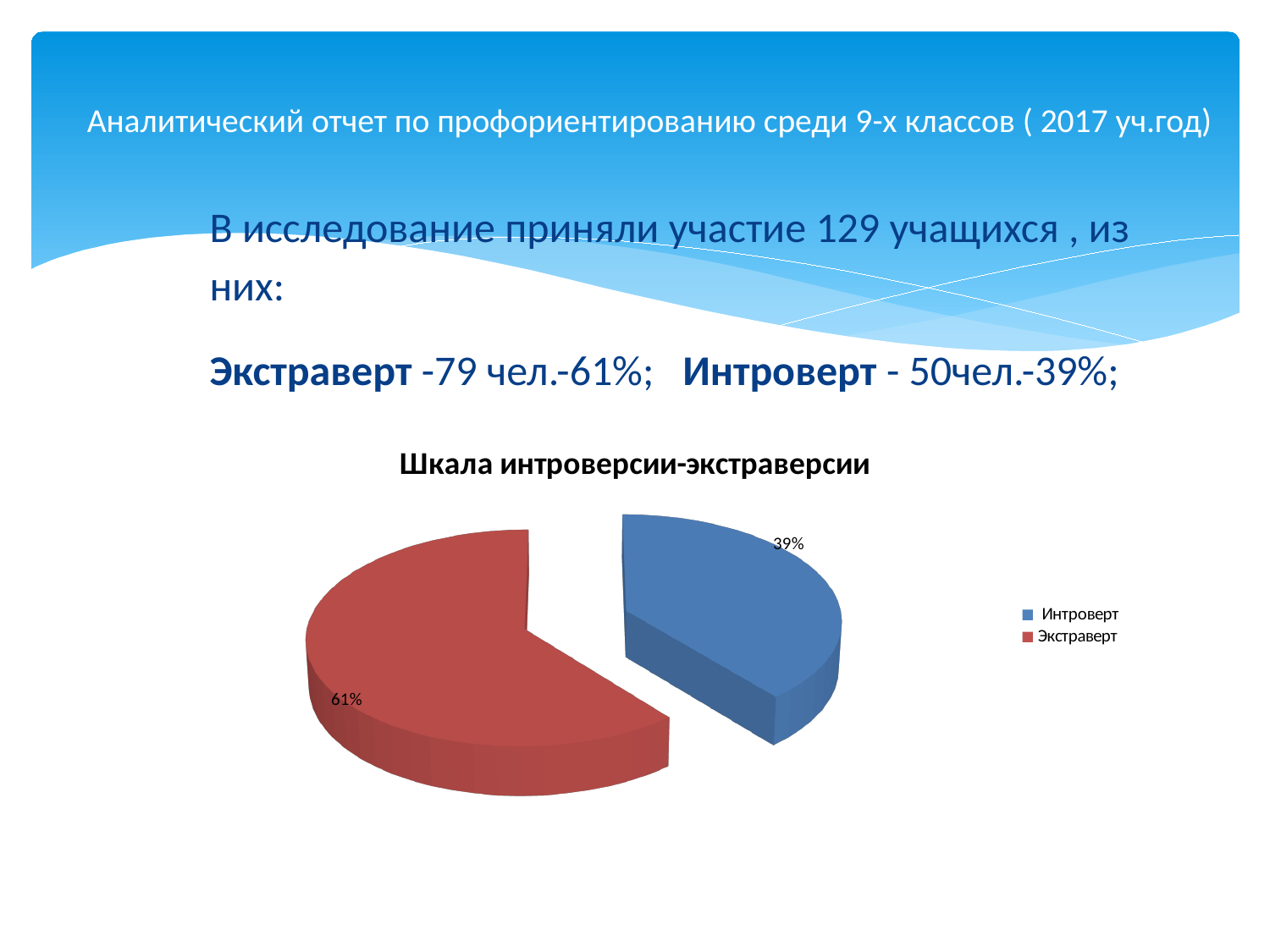
What is the difference in percentage points between the Экстраверт and Интроверт slices? 22% What type of chart is shown on the slide? Pie chart Which is larger, the Интроверт slice or the Экстраверт slice? Экстраверт How many entries does the legend list? 2 What share of the pie does the Интроверт slice represent? 39% What share of the pie does the Экстраверт slice represent? 61% How many slices does the pie chart have? 2 Which category has the largest slice of the pie? Экстраверт What colour is the Интроверт slice? Blue Which category has the smallest slice of the pie? Интроверт What is the title of the chart? Шкала интроверсии-экстраверсии